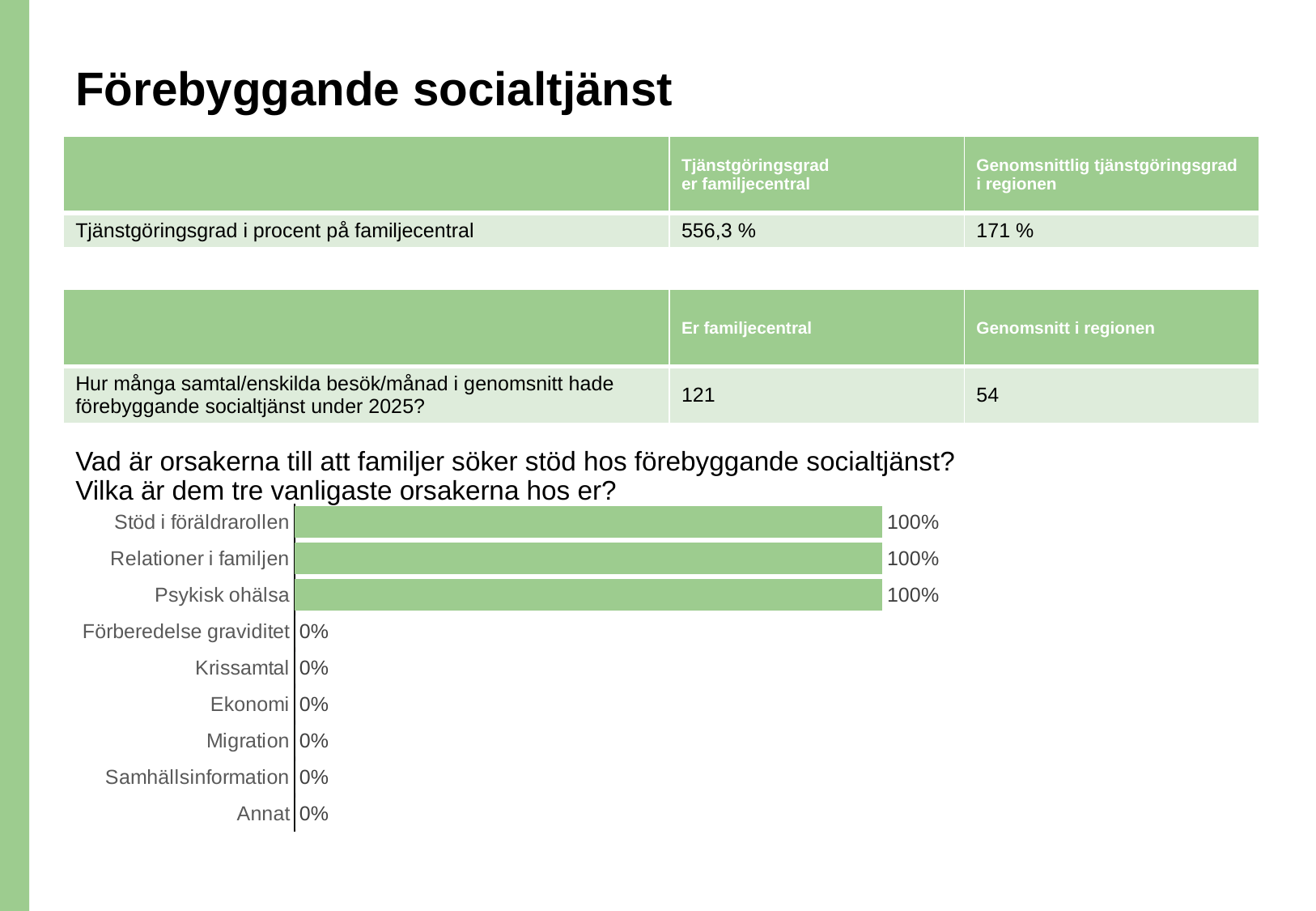
Which has the larger value in the bar chart, Relationer i familjen or Samhällsinformation? Relationer i familjen What is the value for Psykisk ohälsa in the bar chart? 100% What is the value for Relationer i familjen in the bar chart? 100% What is the value for Annat in the bar chart? 0% What kind of chart is shown on the slide? bar chart What is the value for Stöd i föräldrarollen in the bar chart? 100% What is the value for Migration in the bar chart? 0% How many categories are shown in the bar chart? 9 Which has the larger value in the bar chart, Förberedelse graviditet or Stöd i föräldrarollen? Stöd i föräldrarollen What is the difference between the values for Psykisk ohälsa and Krissamtal in the bar chart? 100% What is the value for Ekonomi in the bar chart? 0% How many categories in the bar chart have a value of 100%? 3